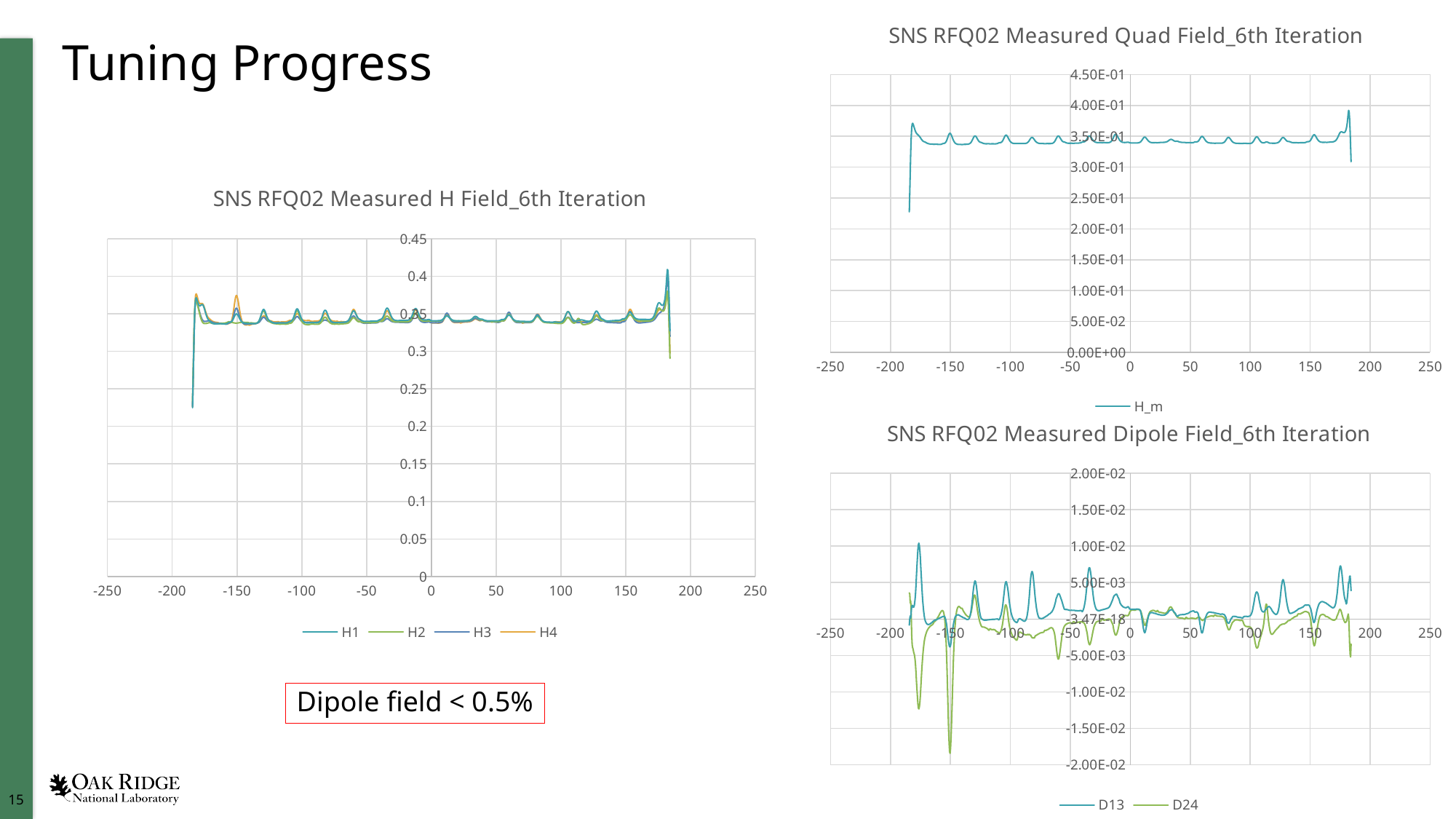
In the 'SNS RFQ02 Measured Quad Field_6th Iteration' chart, is the value of H_m at x = 0 greater or less than 3.00E-01? greater What kind of chart is the 'SNS RFQ02 Measured H Field_6th Iteration' chart? line chart In the 'SNS RFQ02 Measured H Field_6th Iteration' chart, is the value of H1 at x = 0 greater or less than 0.4? less How many series does the legend of the 'SNS RFQ02 Measured H Field_6th Iteration' chart list? 4 What kind of chart is the 'SNS RFQ02 Measured Dipole Field_6th Iteration' chart? line chart How many series does the legend of the 'SNS RFQ02 Measured Dipole Field_6th Iteration' chart list? 2 In the 'SNS RFQ02 Measured H Field_6th Iteration' chart, is the value of H1 at x = 0 greater or less than 0.3? greater How many series does the legend of the 'SNS RFQ02 Measured Quad Field_6th Iteration' chart list? 1 What are the legend entries of the 'SNS RFQ02 Measured H Field_6th Iteration' chart? H1, H2, H3, H4 What is the name of the series in the legend of the 'SNS RFQ02 Measured Quad Field_6th Iteration' chart? H_m